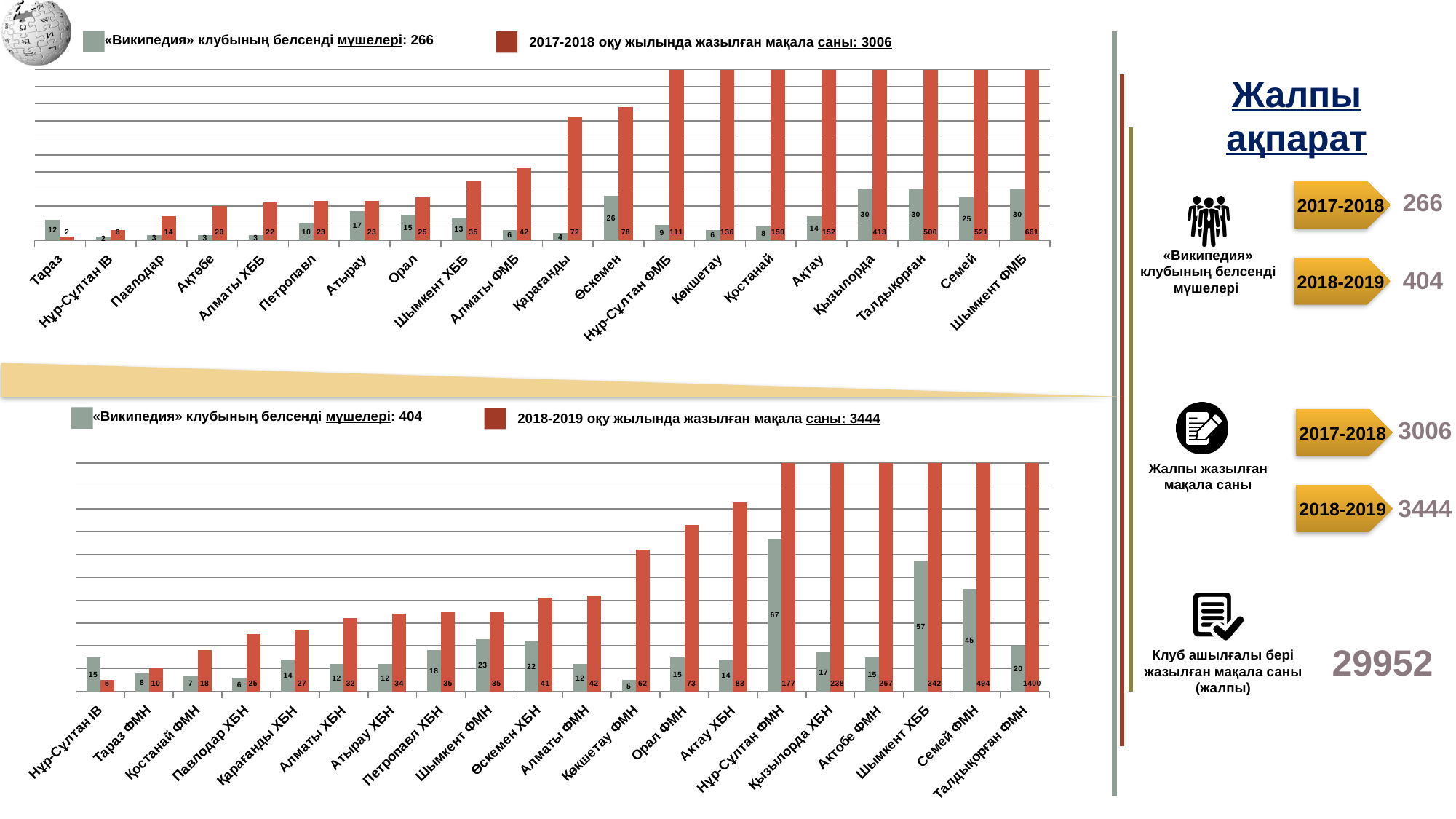
How many categories are shown on the x axis of the bottom chart (2018-2019)? 20 In the top chart (2017-2018), how many active club members does Өскемен have? 26 In the top chart (2017-2018), what is the difference in articles written between Семей and Талдықорған? 21 In the bottom chart (2018-2019), which category has the most active club members? Нұр-Сұлтан ФМН What type of chart is the top chart (2017-2018)? Bar chart In the bottom chart (2018-2019), what is the difference in articles written between Ақтөбе ФМН and Қызылорда ХБН? 29 In the bottom chart (2018-2019), which has more articles written, Семей ФМН or Шымкент ХББ? Семей ФМН In the top chart (2017-2018), which category has the highest number of articles written? Шымкент ФМБ In the top chart (2017-2018), which category has the lowest number of articles written? Тараз In the top chart (2017-2018), how many articles were written by Шымкент ФМБ? 661 In the bottom chart (2018-2019), how many articles were written by Талдықорған ФМН? 1400 In the bottom chart (2018-2019), how many active club members does Нұр-Сұлтан ФМН have? 67